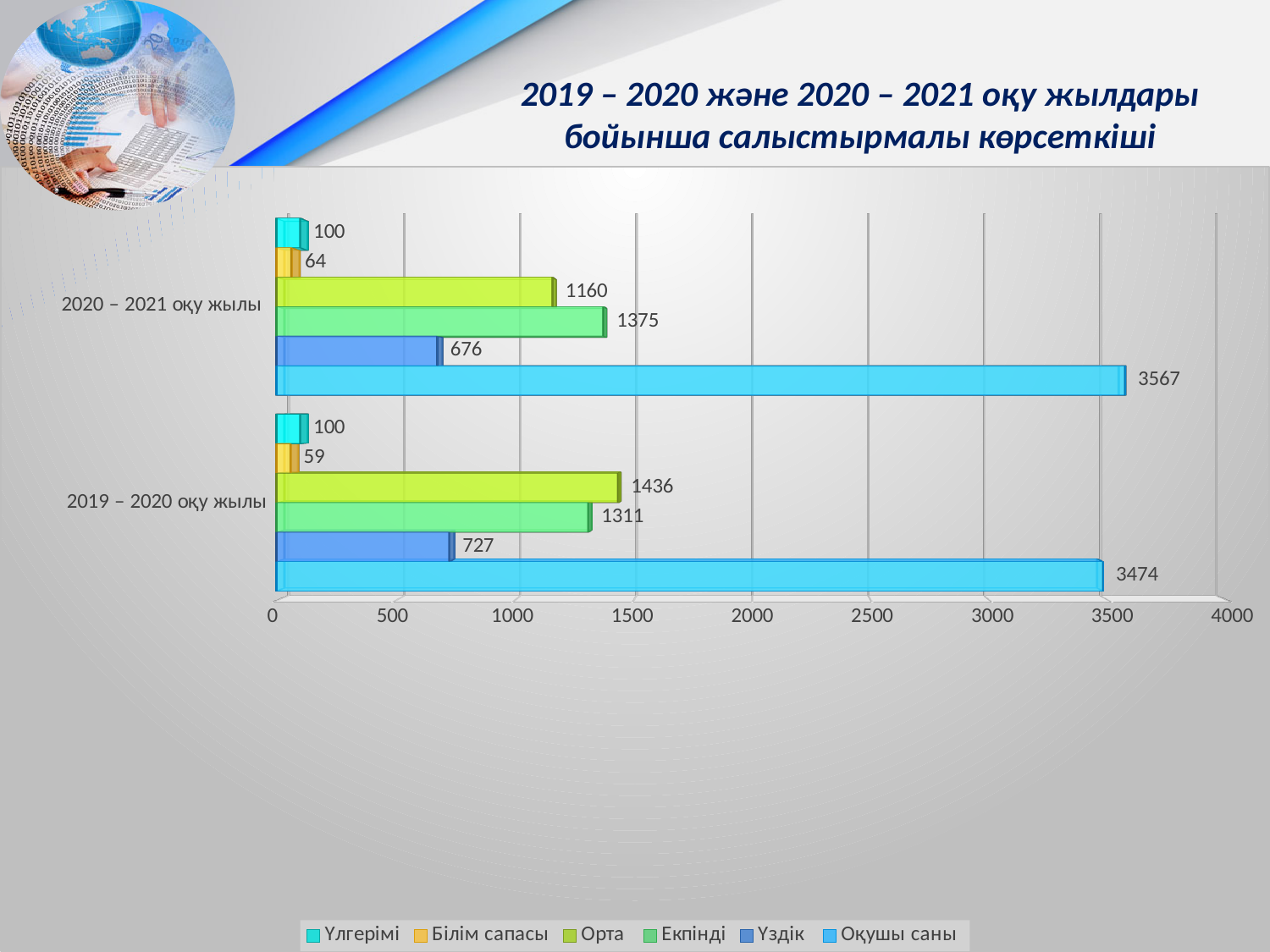
How many categories are shown on the vertical axis? 2 What is the value of Оқушы саны for 2020 – 2021 оқу жылы? 3567 What is the value of Үздік for 2019 – 2020 оқу жылы? 727 What kind of chart is shown on the slide? Bar chart Which series has the highest value for 2019 – 2020 оқу жылы? Оқушы саны What is the value of Орта for 2019 – 2020 оқу жылы? 1436 Which series has the lowest value for 2020 – 2021 оқу жылы? Білім сапасы What is the difference between Оқушы саны for 2020 – 2021 оқу жылы and for 2019 – 2020 оқу жылы? 93 What is the difference between Орта and Екпінді for 2019 – 2020 оқу жылы? 125 What is the value of Білім сапасы for 2020 – 2021 оқу жылы? 64 How many series does the legend list? 6 Which is larger: Екпінді for 2020 – 2021 оқу жылы or Екпінді for 2019 – 2020 оқу жылы? 2020 – 2021 оқу жылы